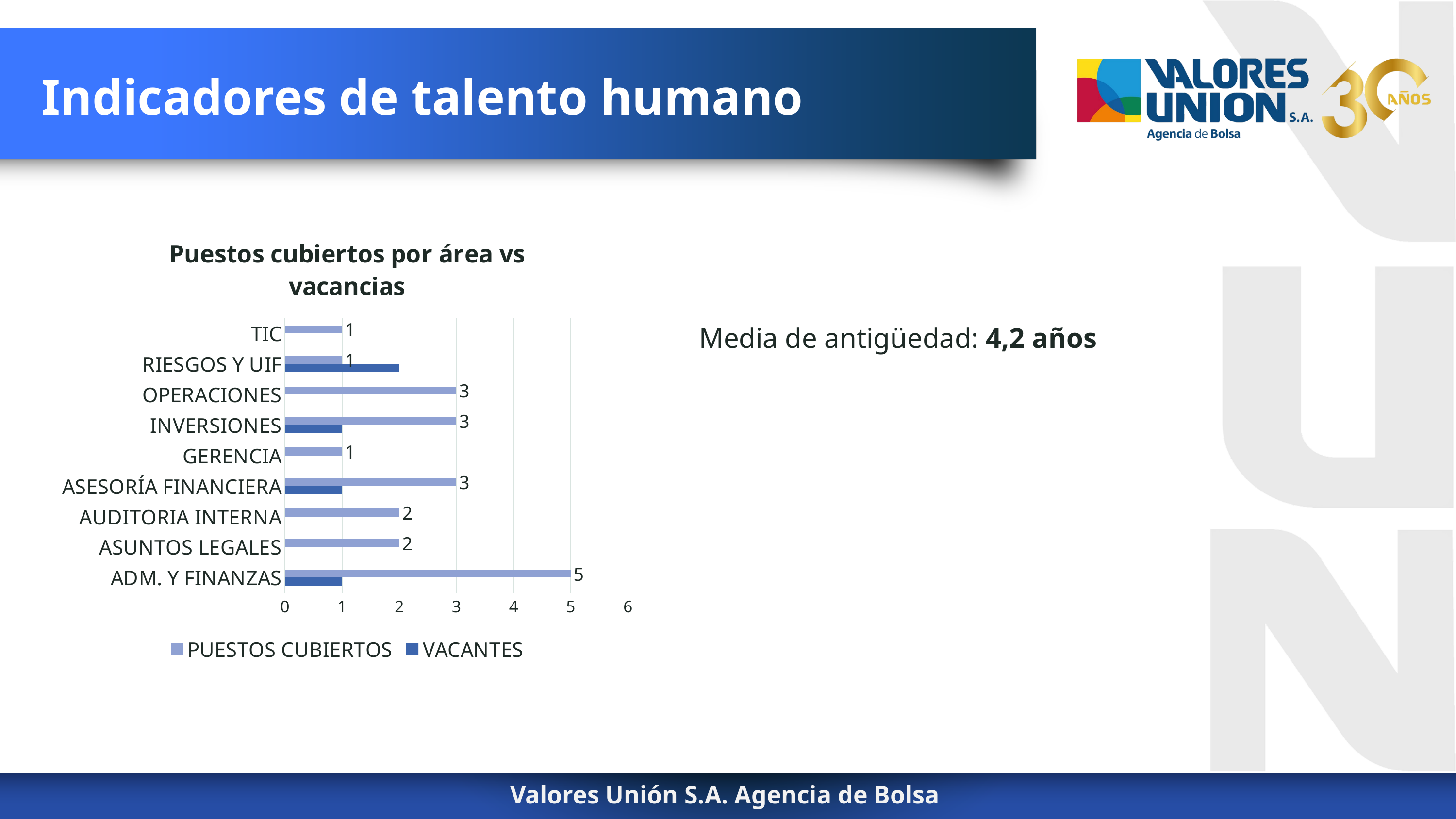
What is the title of the chart? Puestos cubiertos por área vs vacancias Is the VACANTES value for RIESGOS Y UIF greater or less than 1? greater Which has a larger PUESTOS CUBIERTOS value, OPERACIONES or AUDITORIA INTERNA? OPERACIONES What kind of chart is shown on the slide? bar chart What is the PUESTOS CUBIERTOS value for OPERACIONES? 3 What is the PUESTOS CUBIERTOS value for GERENCIA? 1 How many series does the legend list? 2 How many areas (categories) are shown on the chart? 9 What is the difference between the PUESTOS CUBIERTOS values for ADM. Y FINANZAS and OPERACIONES? 2 What is the PUESTOS CUBIERTOS value for AUDITORIA INTERNA? 2 Which area has the highest PUESTOS CUBIERTOS value? ADM. Y FINANZAS What is the PUESTOS CUBIERTOS value for ADM. Y FINANZAS? 5